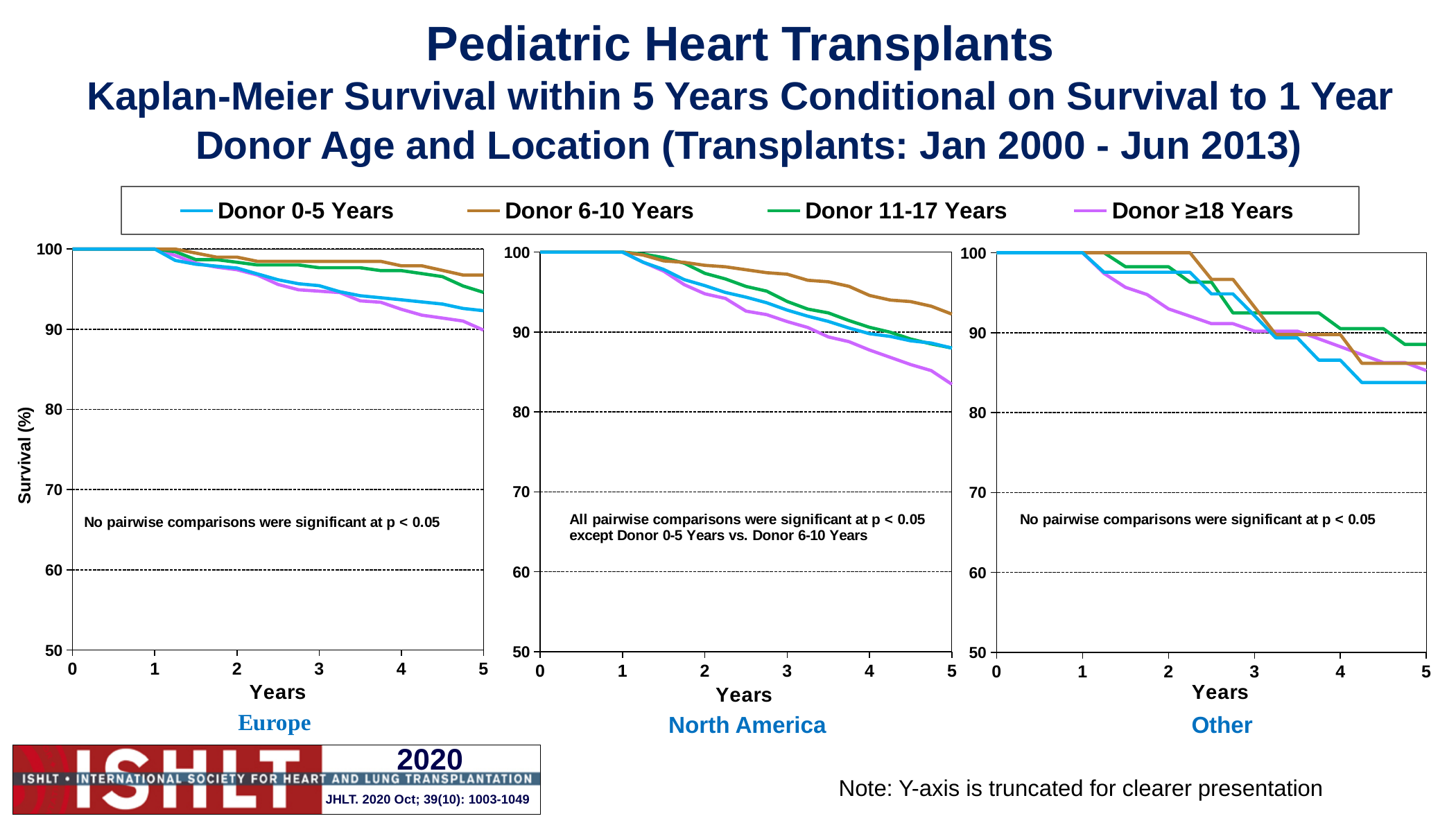
In the North America chart, which donor age group has the highest survival at year 5? Donor 6-10 Years In the Other chart, which donor age group has the highest survival at year 5? Donor 11-17 Years In the Europe chart, is the survival for Donor 0-5 Years at year 5 greater or less than 90? greater In the North America chart, is the survival for Donor ≥18 Years at year 5 greater or less than 90? less In the North America chart, which donor age group has the lowest survival at year 5? Donor ≥18 Years How many series does the legend list? 4 Which location's chart states that all pairwise comparisons were significant at p < 0.05 except Donor 0-5 Years vs. Donor 6-10 Years? North America How many separate chart panels are shown on the slide? 3 In the Other chart, does the survival for Donor 0-5 Years rise or fall as years increase? fall In the Europe chart, which donor age group has the lowest survival at year 5? Donor ≥18 Years What kind of chart is used in the Europe panel? Line chart In the Europe chart, which donor age group has the highest survival at year 5? Donor 6-10 Years